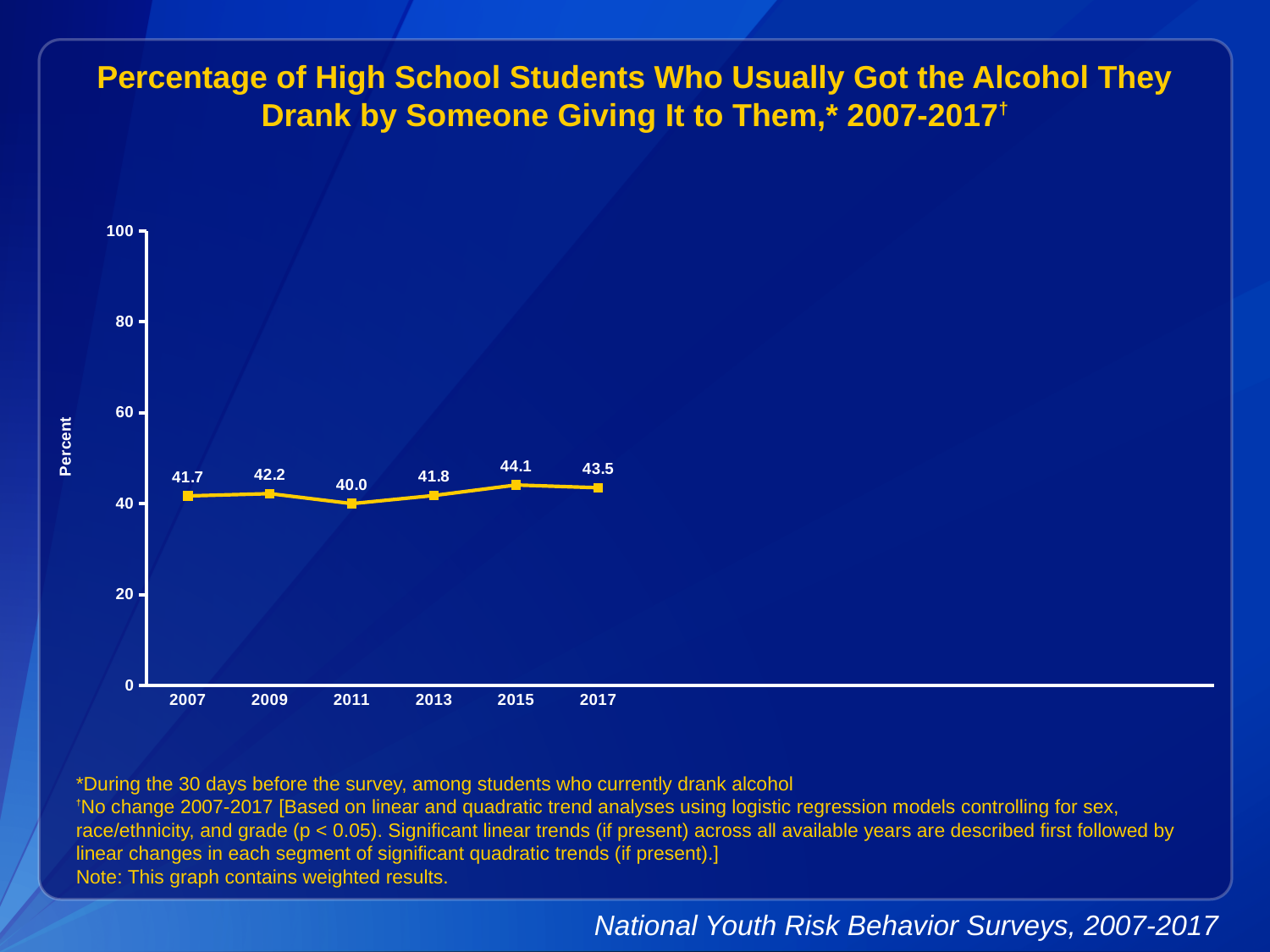
What is the difference between the values for 2015 and 2011? 4.1 What is the label on the vertical axis? Percent What kind of chart is shown? line chart Which year has the lowest value? 2011 What is the value for 2007? 41.7 Is the value for 2015 greater or less than 40? greater What is the value for 2011? 40.0 Does the value rise or fall from 2011 to 2015? rise What is the value for 2017? 43.5 Which is larger, the value for 2009 or the value for 2013? 2009 How many years are plotted on the chart? 6 Which year has the highest value? 2015